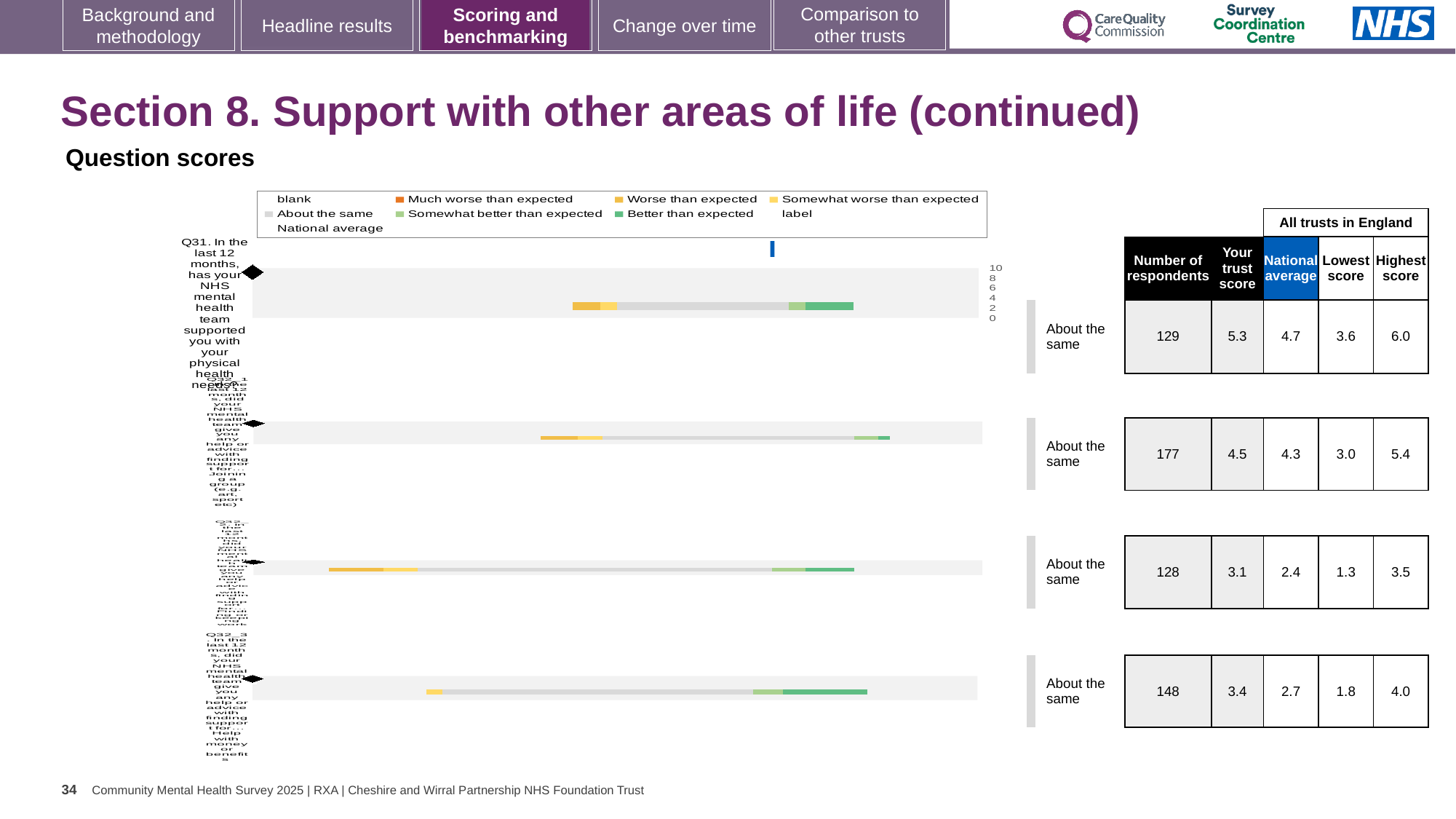
What kind of chart is used to show the question scores on this slide? bar chart What is the trust score for Q31 (support with physical health needs) shown in the table next to the chart? 5.3 How many questions (bars) are plotted in the question scores chart? 4 What is the difference between the trust score and the national average for Q31? 0.6 What is the national average for Q31 (support with physical health needs)? 4.7 Which of the four questions has the largest number of respondents? the second question (177 respondents) What is the lowest score among all trusts in England for the third question (third bar from the top)? 1.3 What is the highest score among all trusts in England for the second question (second bar from the top)? 5.4 For the bottom question (fourth bar), is the trust score or the national average higher? the trust score (3.4) What benchmark category is shown for all four questions on this slide? About the same Which legend entry is shown in dark green in the question scores chart? Better than expected How many respondents answered Q31 (the top bar)? 129